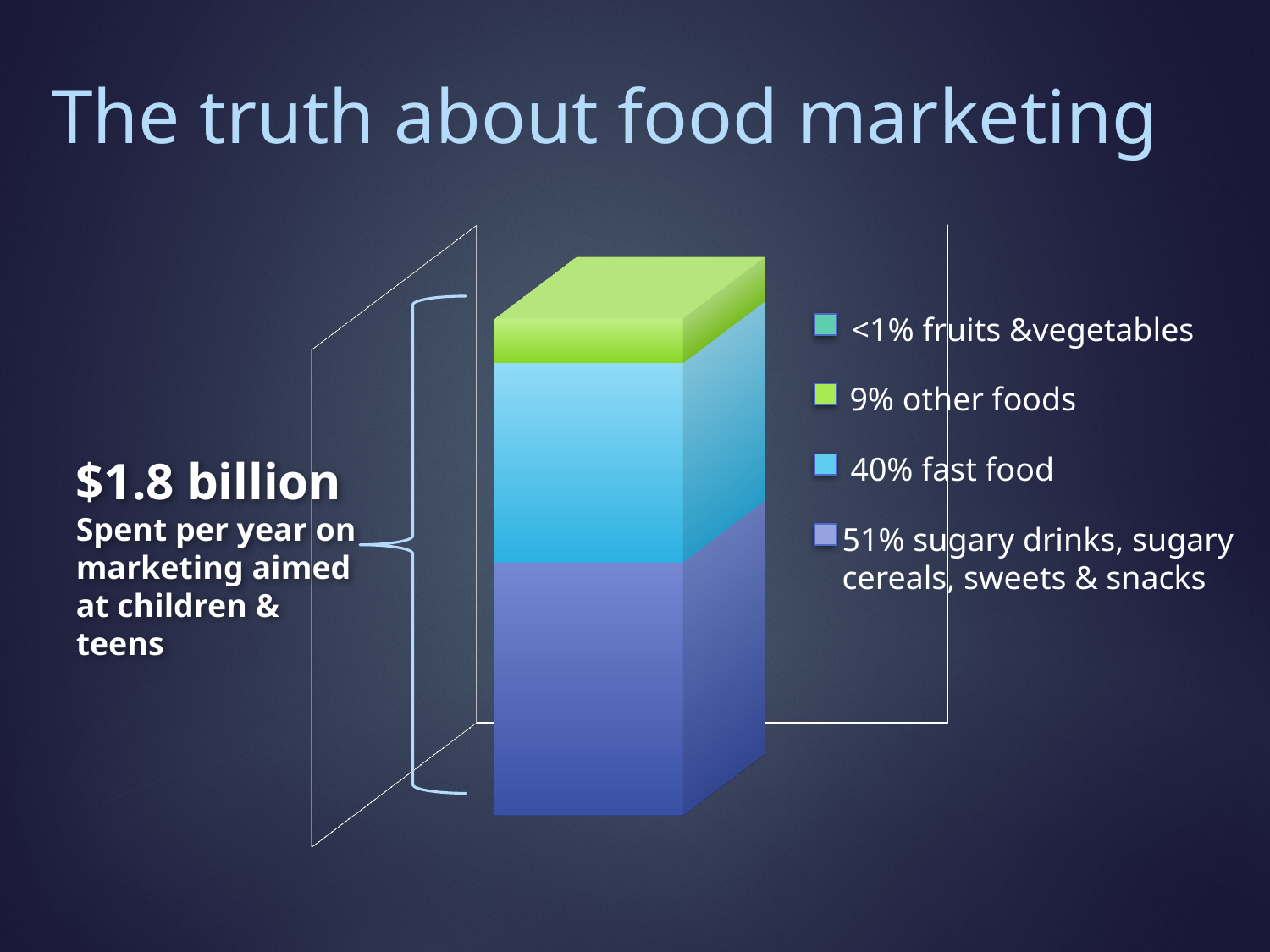
What percentage does the legend give for other foods? 9% How many series does the legend list? 4 What total amount of spending does the stacked bar represent, according to the text on the left? $1.8 billion What percentage does the legend give for fruits & vegetables? <1% What percentage does the legend give for fast food? 40% What is the title of the slide containing the chart? The truth about food marketing Which is larger, the share for fast food or the share for other foods? Fast food Which category has the largest share of the stacked bar? Sugary drinks, sugary cereals, sweets & snacks What percentage does the legend give for sugary drinks, sugary cereals, sweets & snacks? 51% What kind of chart is shown on the slide? Stacked bar chart Which category has the smallest share of the stacked bar? Fruits & vegetables What is the difference between the percentage for sugary drinks, sugary cereals, sweets & snacks and the percentage for fast food? 11%